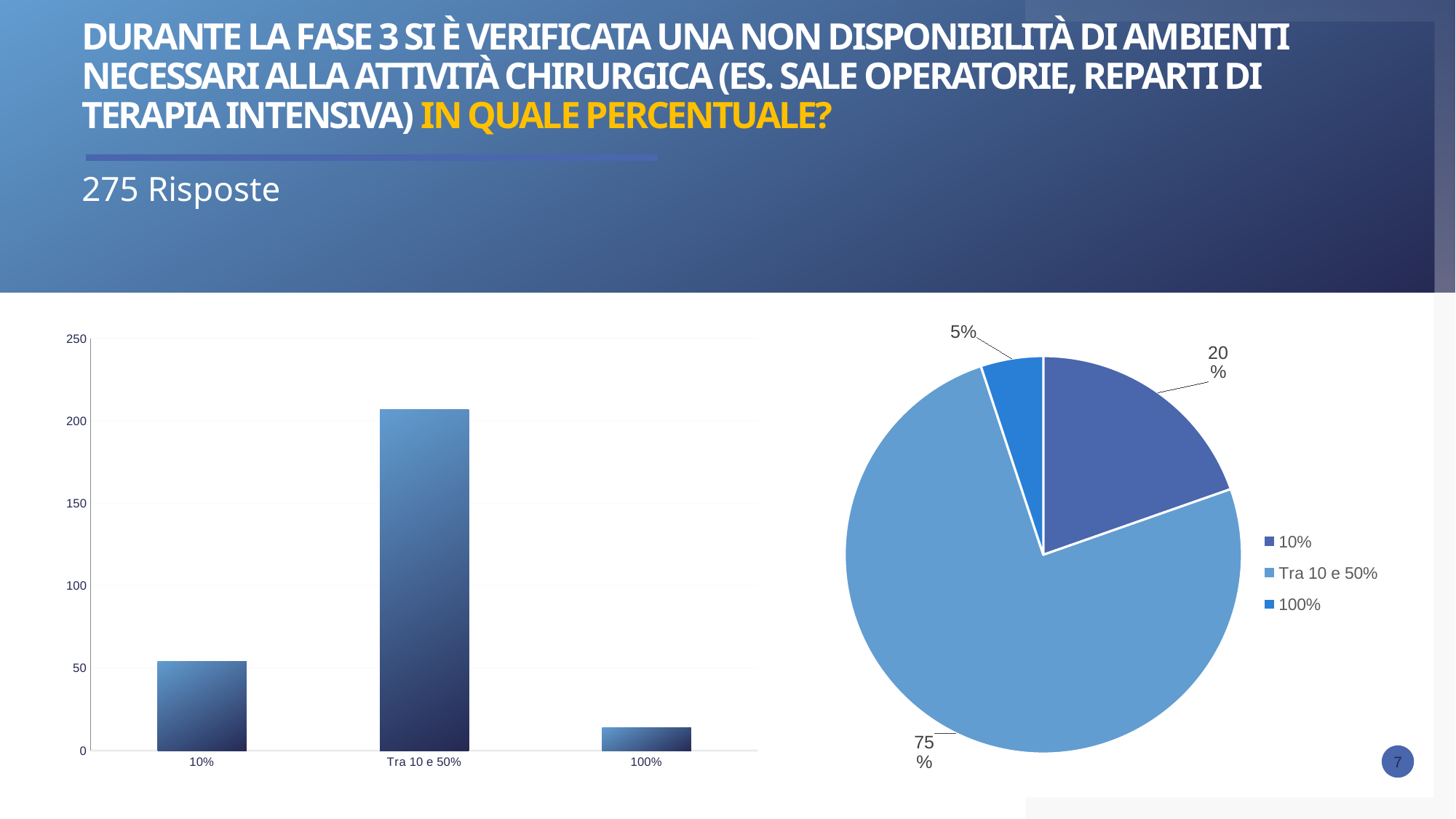
In the bar chart on the left, which category has the lowest value? 100% In the bar chart on the left, which is larger, the value for 10% or the value for 100%? 10% In the bar chart on the left, which category has the highest value? Tra 10 e 50% In the pie chart on the right, what is the difference between the share of Tra 10 e 50% and the share of 10%? 55% How many categories are shown in the bar chart on the left? 3 In the pie chart on the right, what share does the 100% slice have? 5% In the bar chart on the left, is the value for 100% greater or less than 50? less In the bar chart on the left, is the value for 10% greater or less than 100? less In the pie chart on the right, what share does the Tra 10 e 50% slice have? 75% In the bar chart on the left, is the value for Tra 10 e 50% greater or less than 200? greater What kind of chart is the chart on the right of the slide? pie chart What kind of chart is the chart on the left of the slide? bar chart